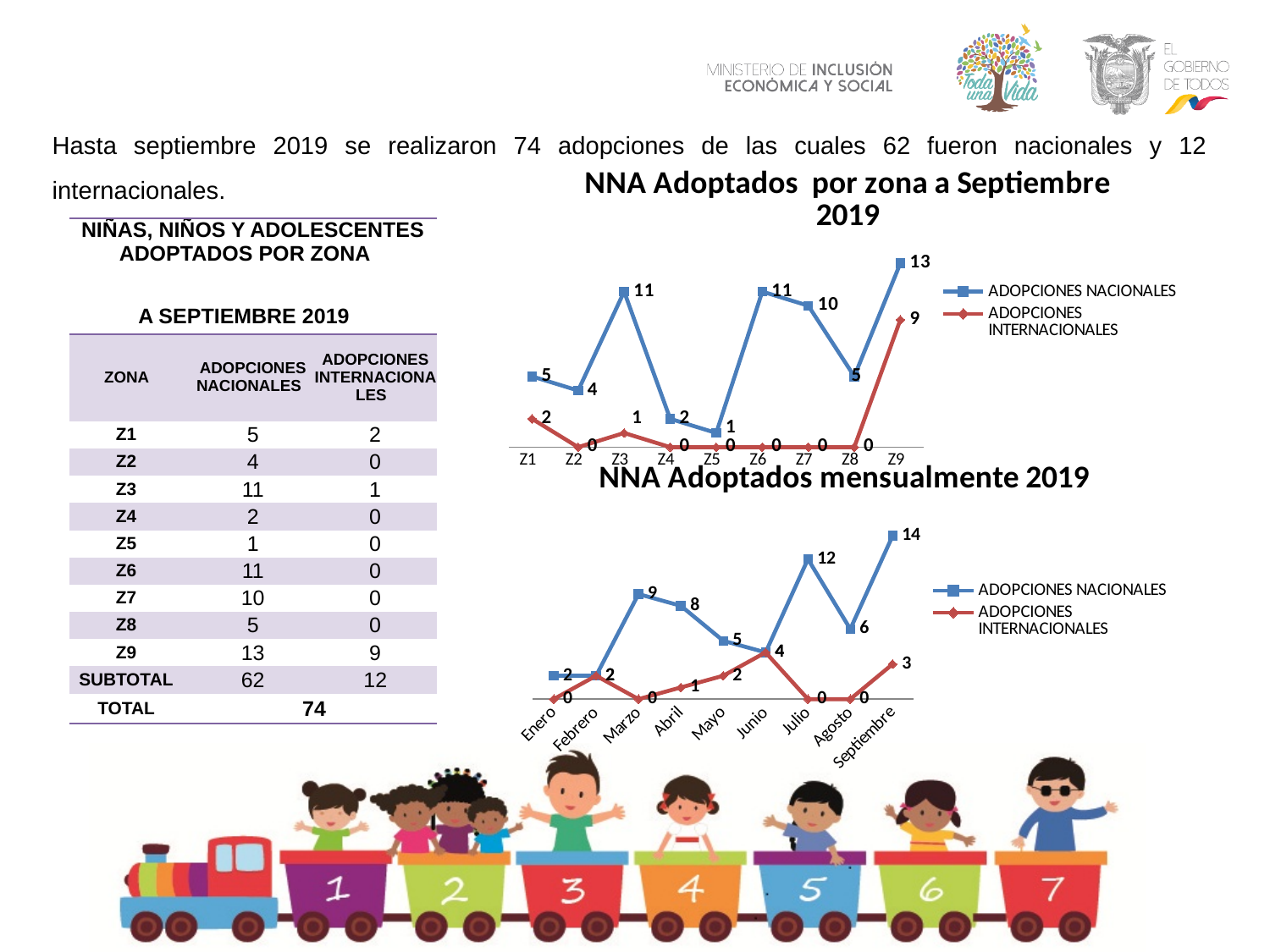
In the chart 'NNA Adoptados mensualmente 2019', which is larger for Marzo: ADOPCIONES NACIONALES or ADOPCIONES INTERNACIONALES? ADOPCIONES NACIONALES In the chart 'NNA Adoptados por zona a Septiembre 2019', which zone has the highest value for ADOPCIONES NACIONALES? Z9 In the chart 'NNA Adoptados por zona a Septiembre 2019', what is the value of ADOPCIONES NACIONALES for Z3? 11 In the chart 'NNA Adoptados mensualmente 2019', what is the value of ADOPCIONES NACIONALES for Julio? 12 In the chart 'NNA Adoptados mensualmente 2019', how many series does the legend list? 2 In the chart 'NNA Adoptados por zona a Septiembre 2019', what type of chart is used? Line chart In the chart 'NNA Adoptados por zona a Septiembre 2019', which zone has the lowest value for ADOPCIONES NACIONALES? Z5 In the chart 'NNA Adoptados mensualmente 2019', what is the value of ADOPCIONES INTERNACIONALES for Junio? 4 In the chart 'NNA Adoptados por zona a Septiembre 2019', what is the difference between ADOPCIONES NACIONALES and ADOPCIONES INTERNACIONALES for Z9? 4 In the chart 'NNA Adoptados por zona a Septiembre 2019', how many zones are shown on the x axis? 9 In the chart 'NNA Adoptados mensualmente 2019', which month has the highest value for ADOPCIONES NACIONALES? Septiembre In the chart 'NNA Adoptados por zona a Septiembre 2019', what is the value of ADOPCIONES INTERNACIONALES for Z9? 9